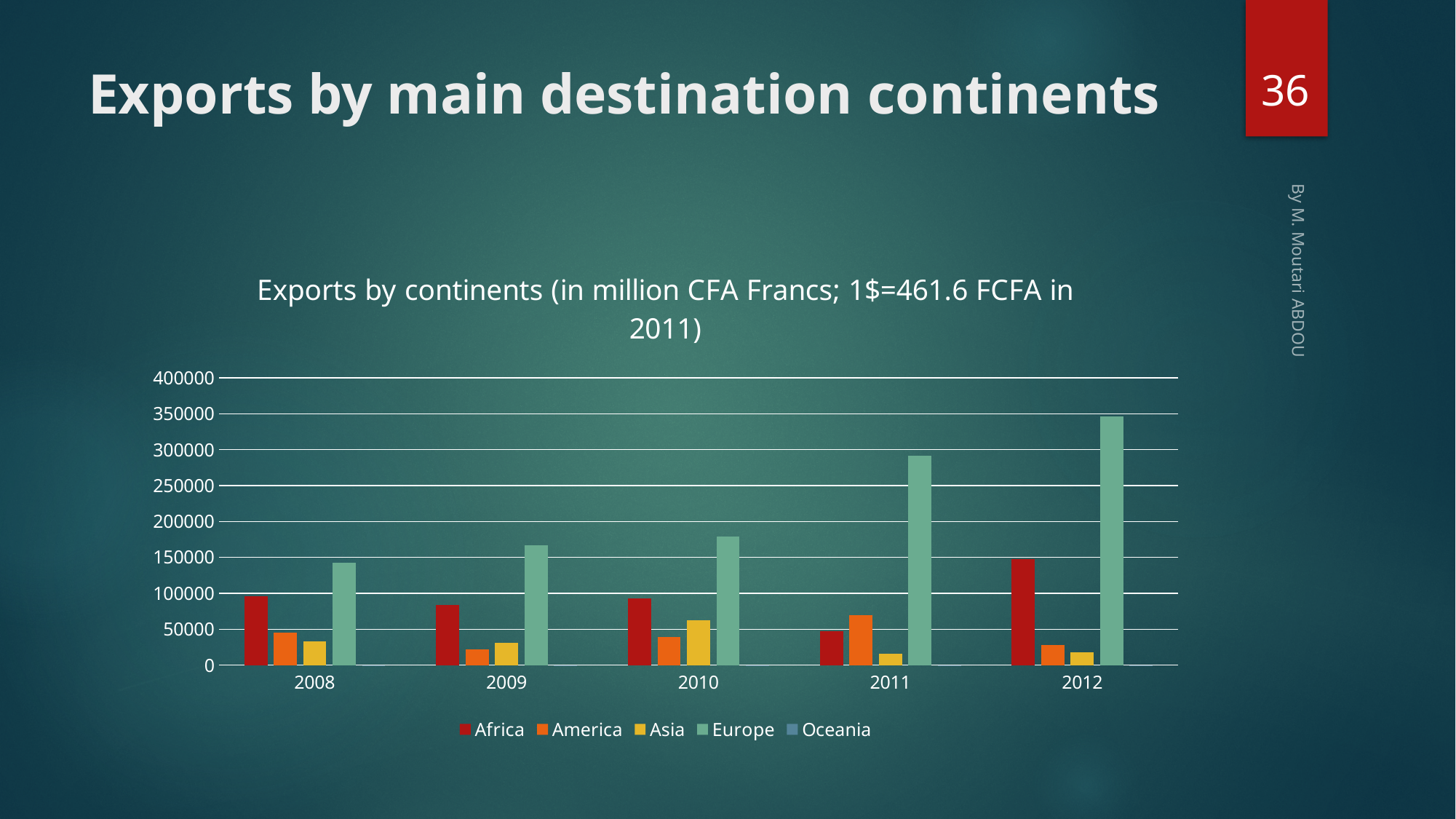
Do the Europe values rise or fall from 2008 to 2012? Rise How many series does the legend list? 5 In which year is the Europe bar the highest? 2012 What is the title of the chart? Exports by continents (in million CFA Francs; 1$=461.6 FCFA in 2011) How many years are shown on the x axis? 5 Is the value for Europe in 2011 greater or less than 250000? greater In 2010, which is larger: the value for Asia or the value for America? Asia In 2011, which is larger: the value for Africa or the value for America? America Is the value for Europe in 2012 greater or less than 300000? greater What kind of chart is shown on the slide? Bar chart In which year is the Europe bar the lowest? 2008 Is the value for Africa in 2008 greater or less than 50000? greater